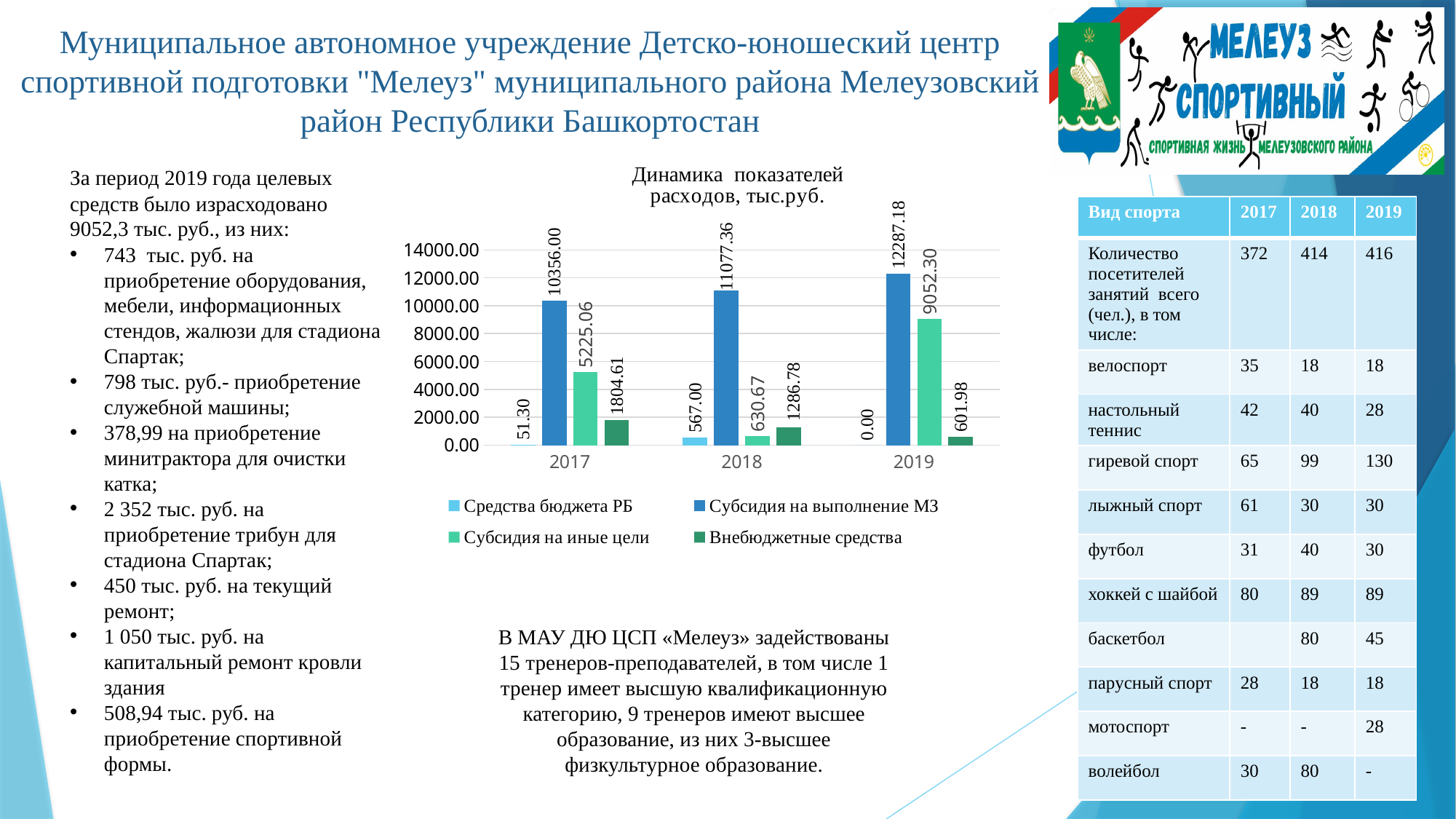
In which year is Субсидия на выполнение МЗ the highest? 2019 What is the value of Средства бюджета РБ in 2018? 567.00 What is the value of Субсидия на выполнение МЗ in 2019? 12287.18 What is the title of the chart on the slide? Динамика показателей расходов, тыс.руб. What is the difference between Субсидия на выполнение МЗ in 2019 and in 2018? 1209.82 Does Субсидия на выполнение МЗ rise or fall from 2017 to 2019? rise What is the value of Субсидия на иные цели in 2017? 5225.06 How many series does the chart legend list? 4 In which year is Средства бюджета РБ the lowest? 2019 What is the value of Внебюджетные средства in 2019? 601.98 How many year categories are shown on the x axis of the chart? 3 What type of chart is shown on the slide? bar chart